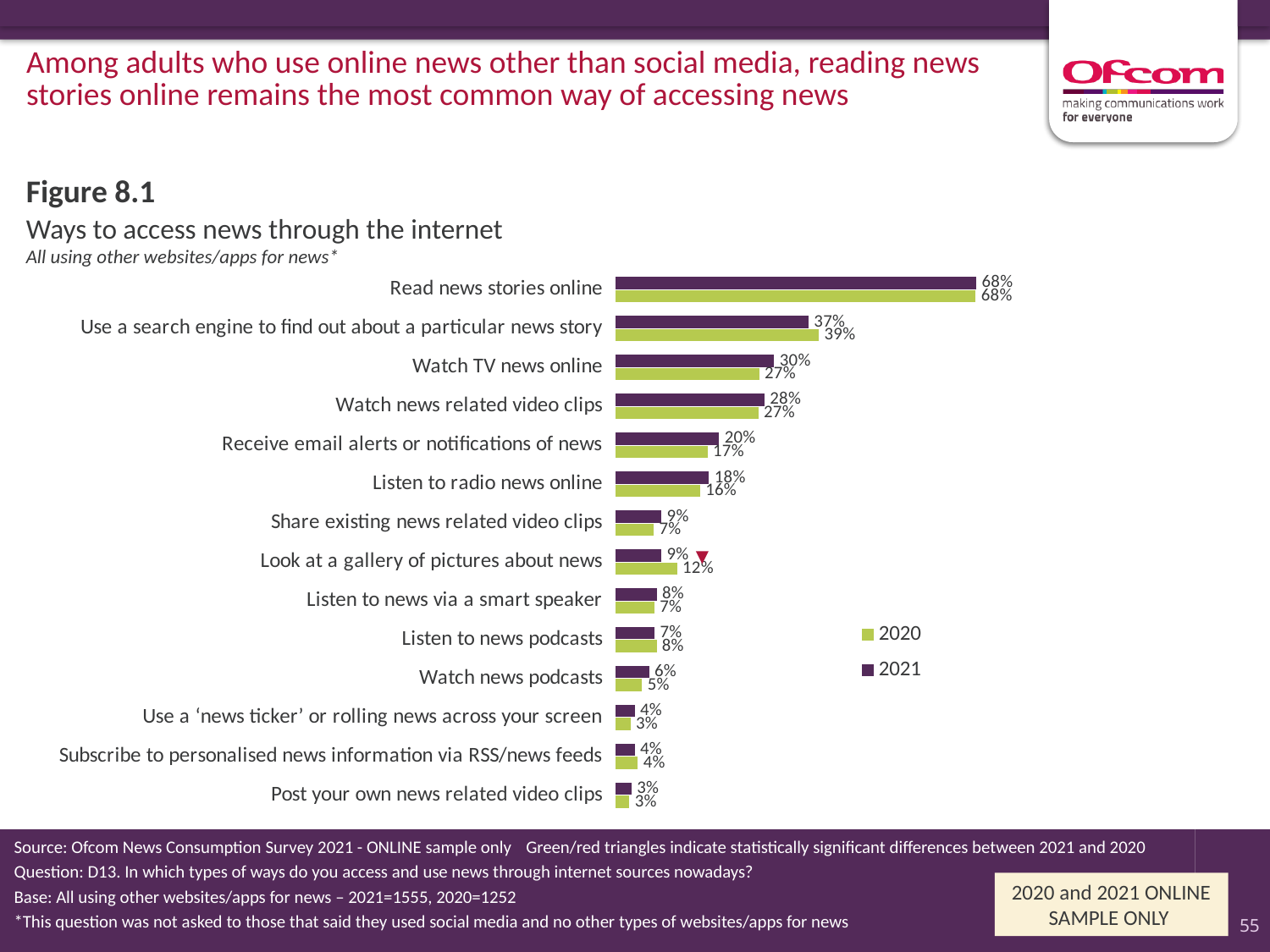
What percentage of adults read news stories online in 2021? 68% How many series does the legend list? 2 Which way of accessing news has the highest value in 2021? Read news stories online What percentage watched TV news online in 2021? 30% What is the difference between the 2021 and 2020 values for receiving email alerts or notifications of news? 3 percentage points What was the 2020 value for using a search engine to find out about a particular news story? 39% Which is larger for listening to news podcasts: the 2020 value or the 2021 value? 2020 What was the 2020 value for looking at a gallery of pictures about news? 12% What type of chart is shown on the slide? Bar chart How many ways of accessing news are listed in the chart? 14 Which colour represents the 2021 series in the chart? Purple Which way of accessing news has the lowest value in 2021? Post your own news related video clips